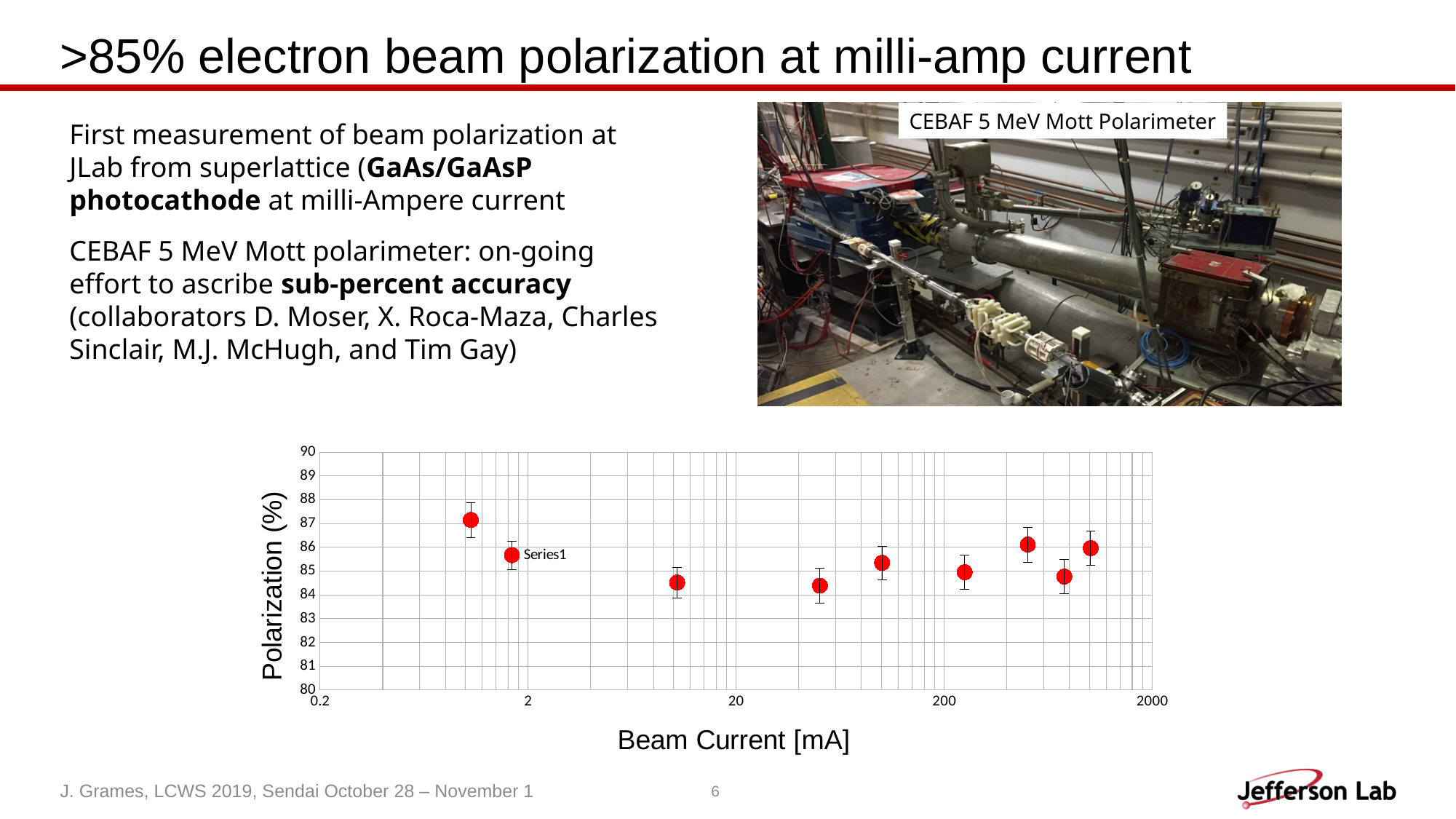
How many data points are plotted in the chart? 9 Which data point has the highest polarization: the leftmost point or the rightmost point? the leftmost point What is the label of the chart's x axis? Beam Current [mA] Is the polarization value of the leftmost data point (lowest beam current) greater or less than 86? greater Which data point has the highest polarization in the chart? the leftmost point (lowest beam current, around 1 mA) Are all plotted polarization values greater or less than 83? greater Is the polarization value of the data point near 20 mA beam current greater or less than 85? less What kind of chart is shown on the slide? scatter plot What is the maximum value shown on the y axis of the chart? 90